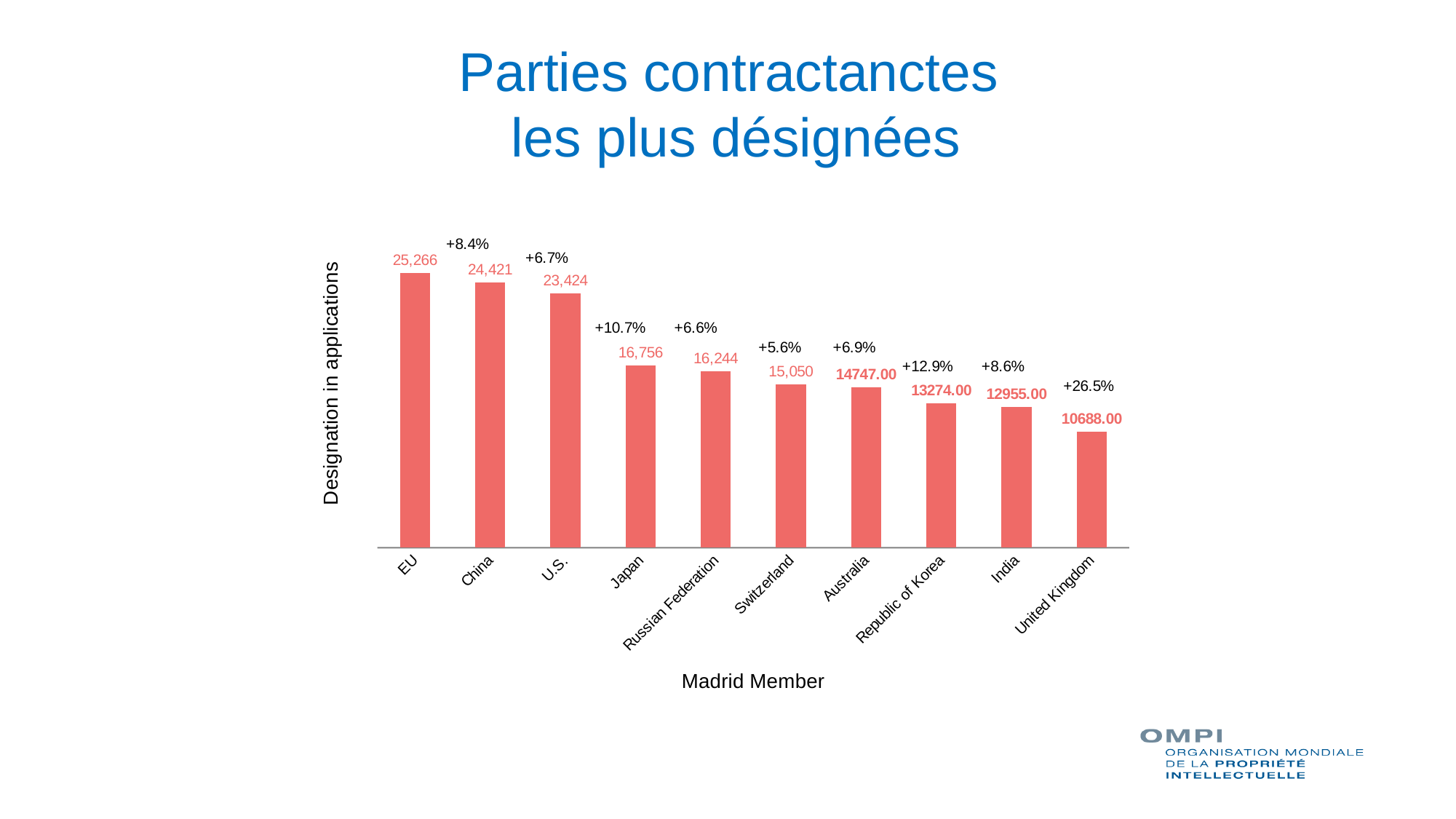
What is the difference between the values for the EU and China? 845 What is the value shown for Australia? 14747.00 What kind of chart is shown on the slide? bar chart What is the number of designations in applications for the EU? 25,266 Which Madrid member has the highest number of designations in applications? EU What is the label of the y axis? Designation in applications Which has more designations in applications, Switzerland or the Russian Federation? Russian Federation How many Madrid members are shown on the chart? 10 What is the value shown for the United Kingdom? 10688.00 Which Madrid member has the lowest number of designations in applications? United Kingdom Do the values rise or fall from left to right along the x axis? fall What is the number of designations in applications for Japan? 16,756